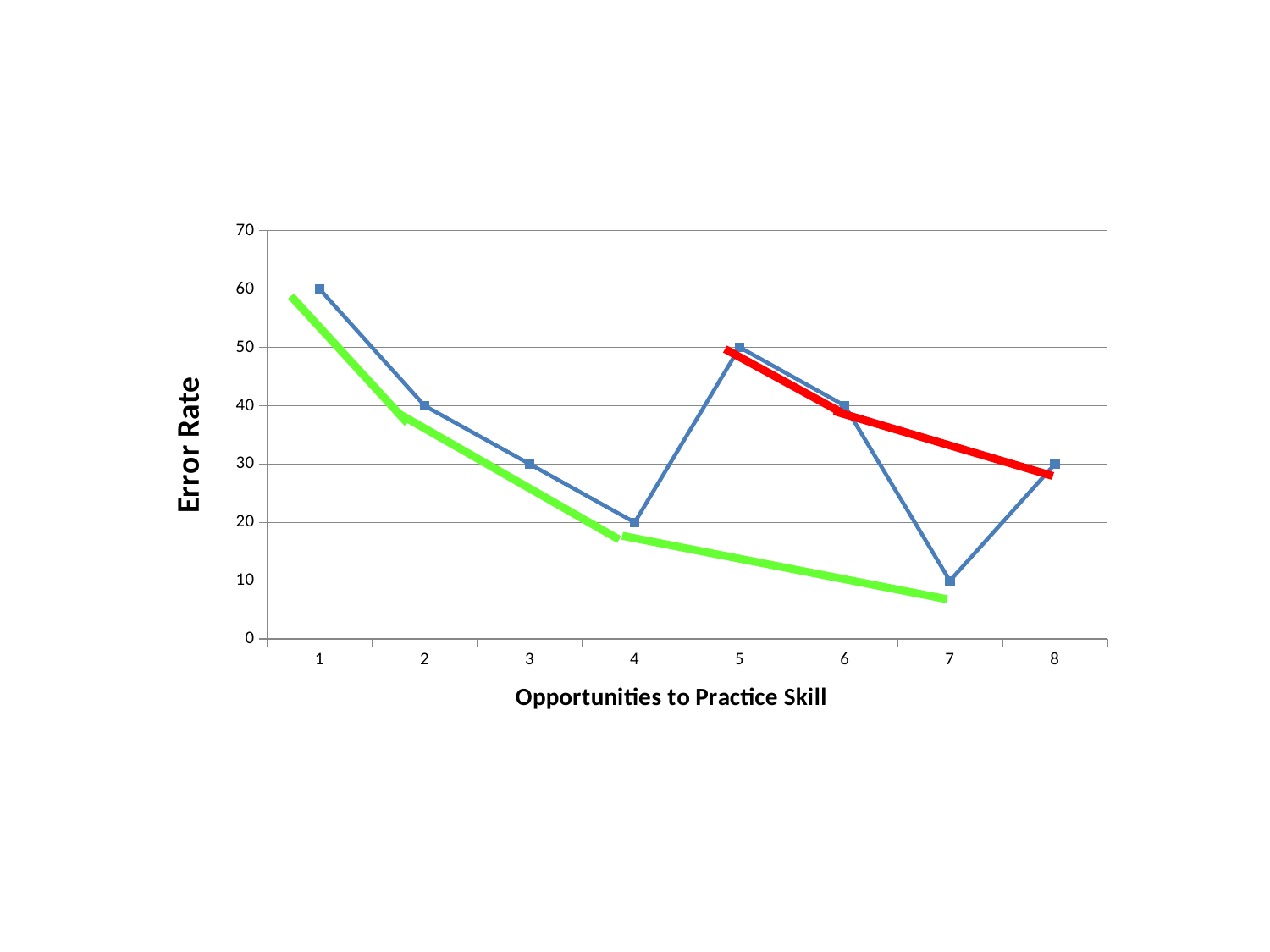
At which opportunity is the error rate highest? 1 At which opportunity is the error rate lowest? 7 Which has a higher error rate, opportunity 5 or opportunity 8? opportunity 5 Does the error rate rise or fall from opportunity 1 to opportunity 4? fall How many opportunities to practice skill are plotted on the x axis? 8 What is the error rate at opportunity 4? 20 What is the difference in error rate between opportunity 1 and opportunity 4? 40 What is the error rate at opportunity 5? 50 What is the label of the y axis? Error Rate What kind of chart is shown on the slide? line chart What is the error rate at opportunity 7? 10 What is the error rate at opportunity 1? 60